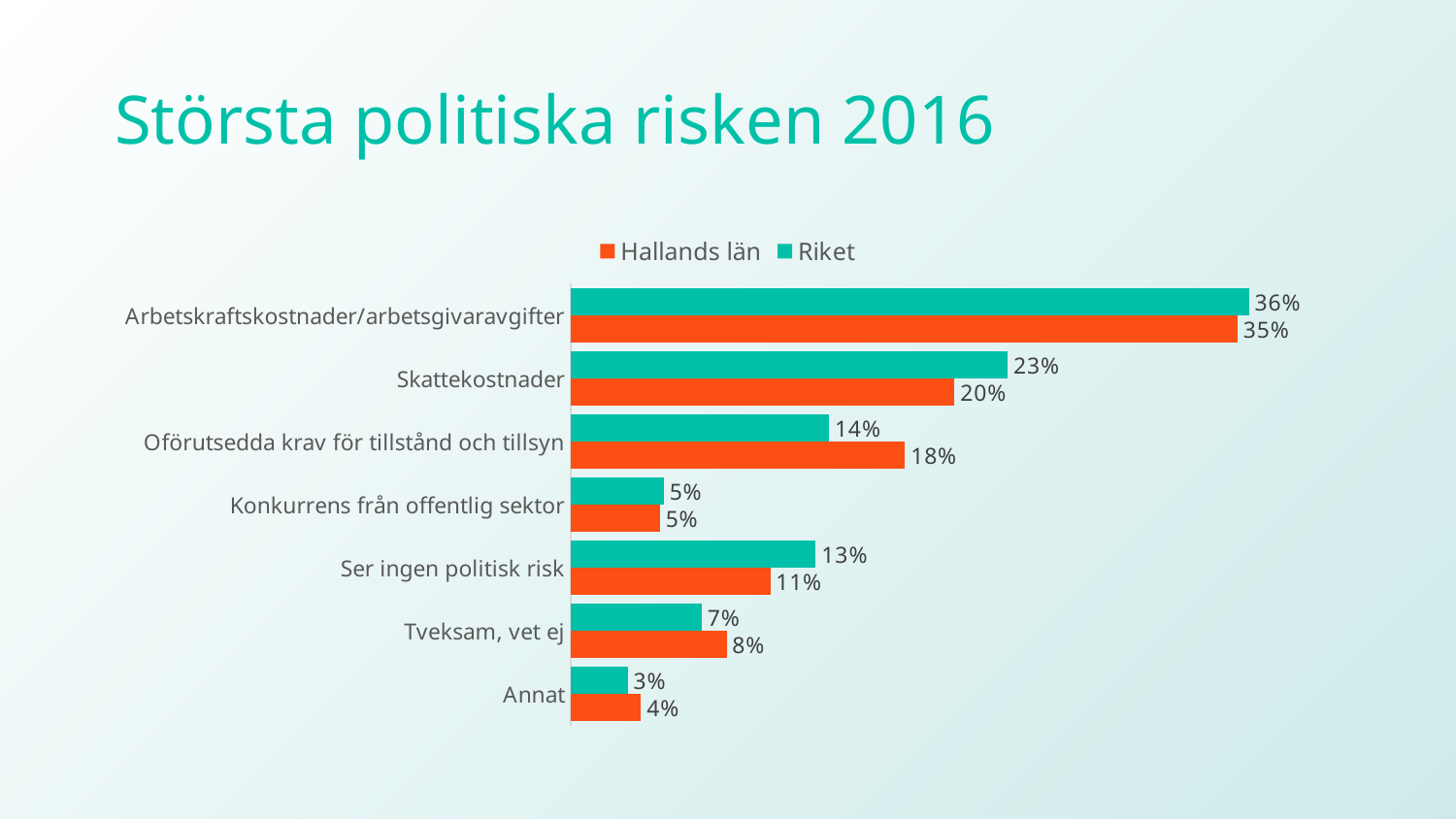
Which category has the lowest value for Hallands län? Annat Which category has the highest value for Riket? Arbetskraftskostnader/arbetsgivaravgifter Which series is shown in orange? Hallands län What is the value for Riket for Oförutsedda krav för tillstånd och tillsyn? 14% How many categories are shown in the chart? 7 What is the value for Hallands län for Skattekostnader? 20% What is the difference between Riket and Hallands län for Oförutsedda krav för tillstånd och tillsyn? 4% How many series does the legend list? 2 What kind of chart is shown on the slide? Bar chart What is the title of the slide? Största politiska risken 2016 Which is larger for Skattekostnader, Hallands län or Riket? Riket What is the value for Hallands län for Ser ingen politisk risk? 11%